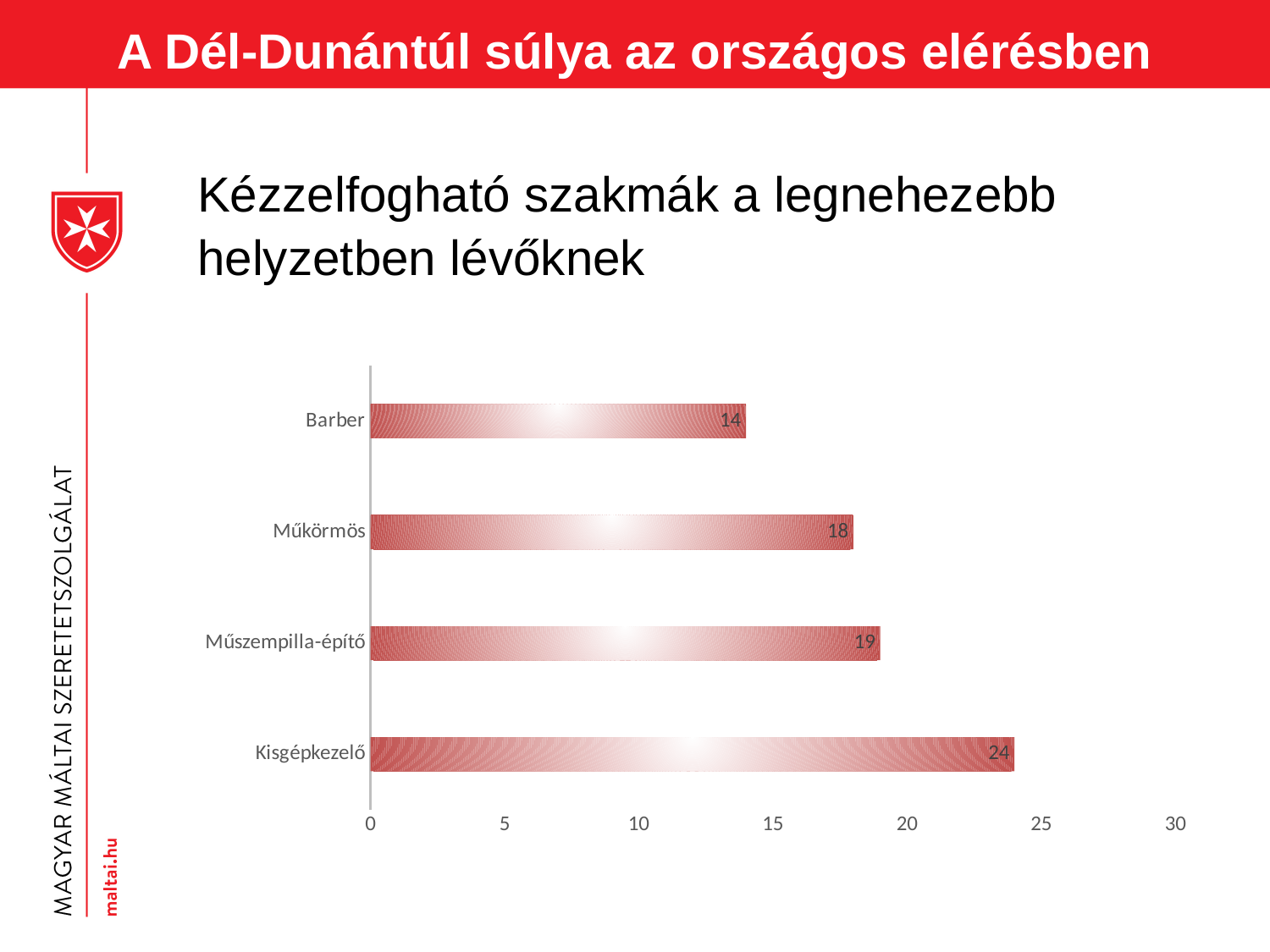
Is the value for Kisgépkezelő greater or less than 20? greater Which category has the highest value? Kisgépkezelő What is the value for Műszempilla-építő? 19 What is the value for Kisgépkezelő? 24 What kind of chart is shown on the slide? Bar chart What is the difference between the values for Műszempilla-építő and Műkörmös? 1 Which category has the lowest value? Barber What is the difference between the values for Kisgépkezelő and Barber? 10 What is the value for Műkörmös? 18 What is the value for Barber? 14 How many categories are shown in the chart? 4 Which is larger, the value for Műkörmös or the value for Barber? Műkörmös